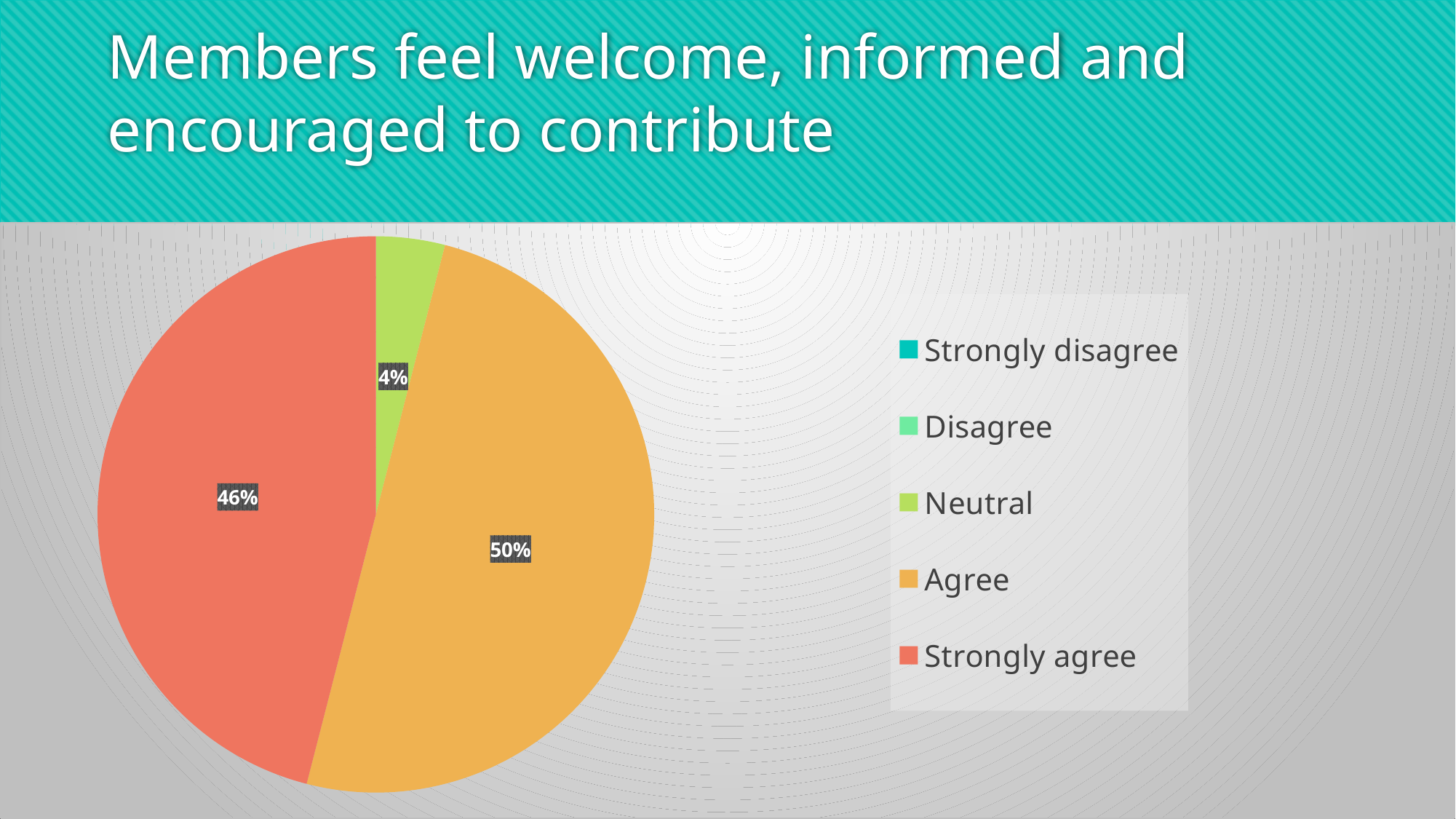
What colour is the Strongly agree slice? Red/orange Which response has the largest share of the pie? Agree What is the title of the slide containing the chart? Members feel welcome, informed and encouraged to contribute Which labelled slice has the smallest share of the pie? Neutral What percentage of members answered Agree? 50% How many entries does the legend list? 5 What is the combined share of Agree and Strongly agree? 96% What percentage of members answered Neutral? 4% What percentage of members answered Strongly agree? 46% What kind of chart is shown on the slide? Pie chart What is the difference between the Agree and Strongly agree shares? 4% Which is larger, the Agree share or the Strongly agree share? Agree